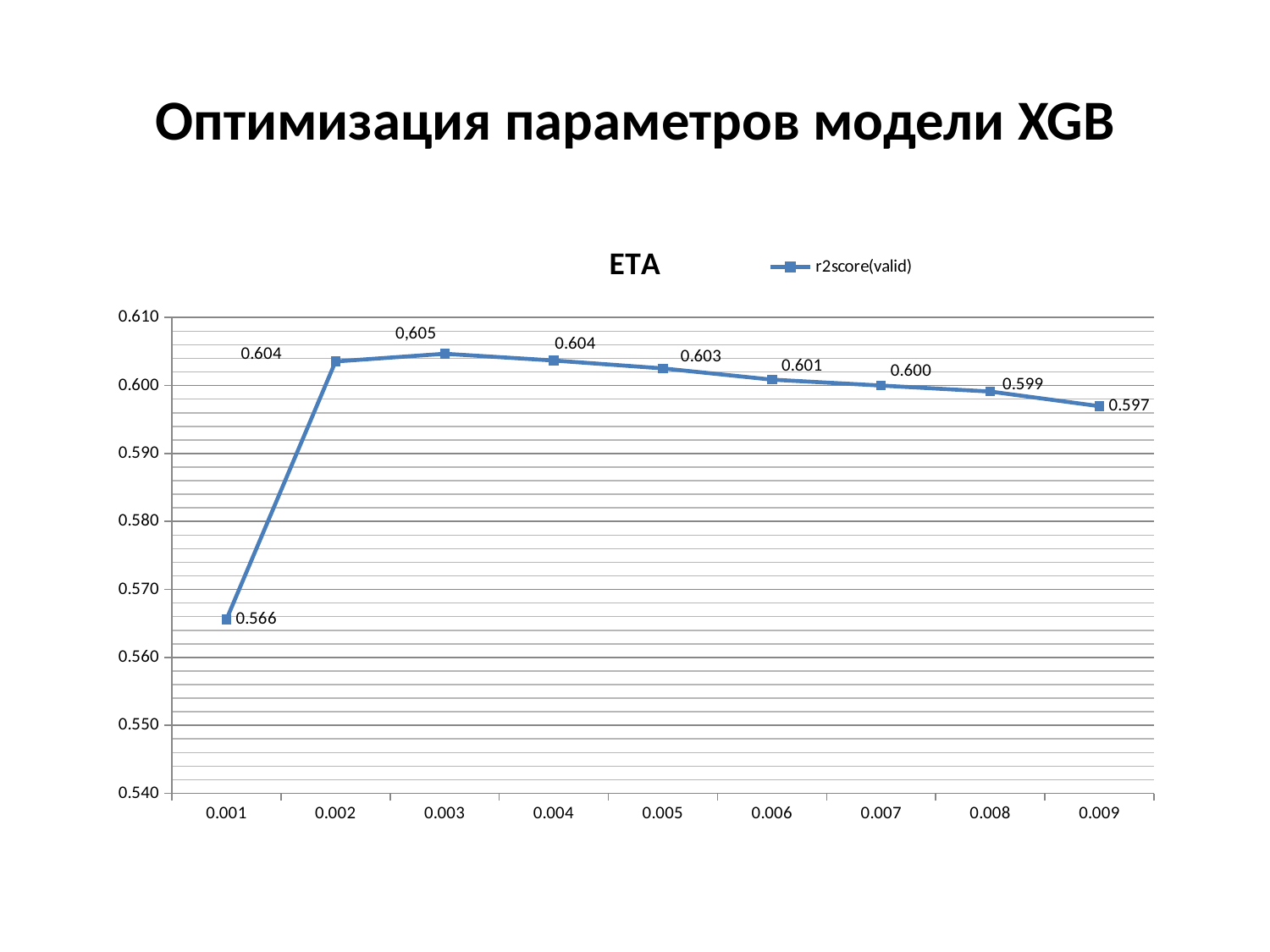
At which ETA value is r2score(valid) lowest? 0.001 What is the r2score(valid) value at ETA 0.009? 0.597 How many series does the legend list? 1 Which has a higher r2score(valid): ETA 0.002 or ETA 0.009? 0.002 Is the r2score(valid) value at ETA 0.001 greater or less than 0.570? less What kind of chart is shown on the slide? line chart Does r2score(valid) rise or fall as ETA increases from 0.003 to 0.009? fall At which ETA value is r2score(valid) highest? 0.003 What is the r2score(valid) value at ETA 0.001? 0.566 What is the r2score(valid) value at ETA 0.003? 0,605 How many ETA values are plotted on the chart? 9 What is the difference between the r2score(valid) at ETA 0.002 and at ETA 0.001? 0.038